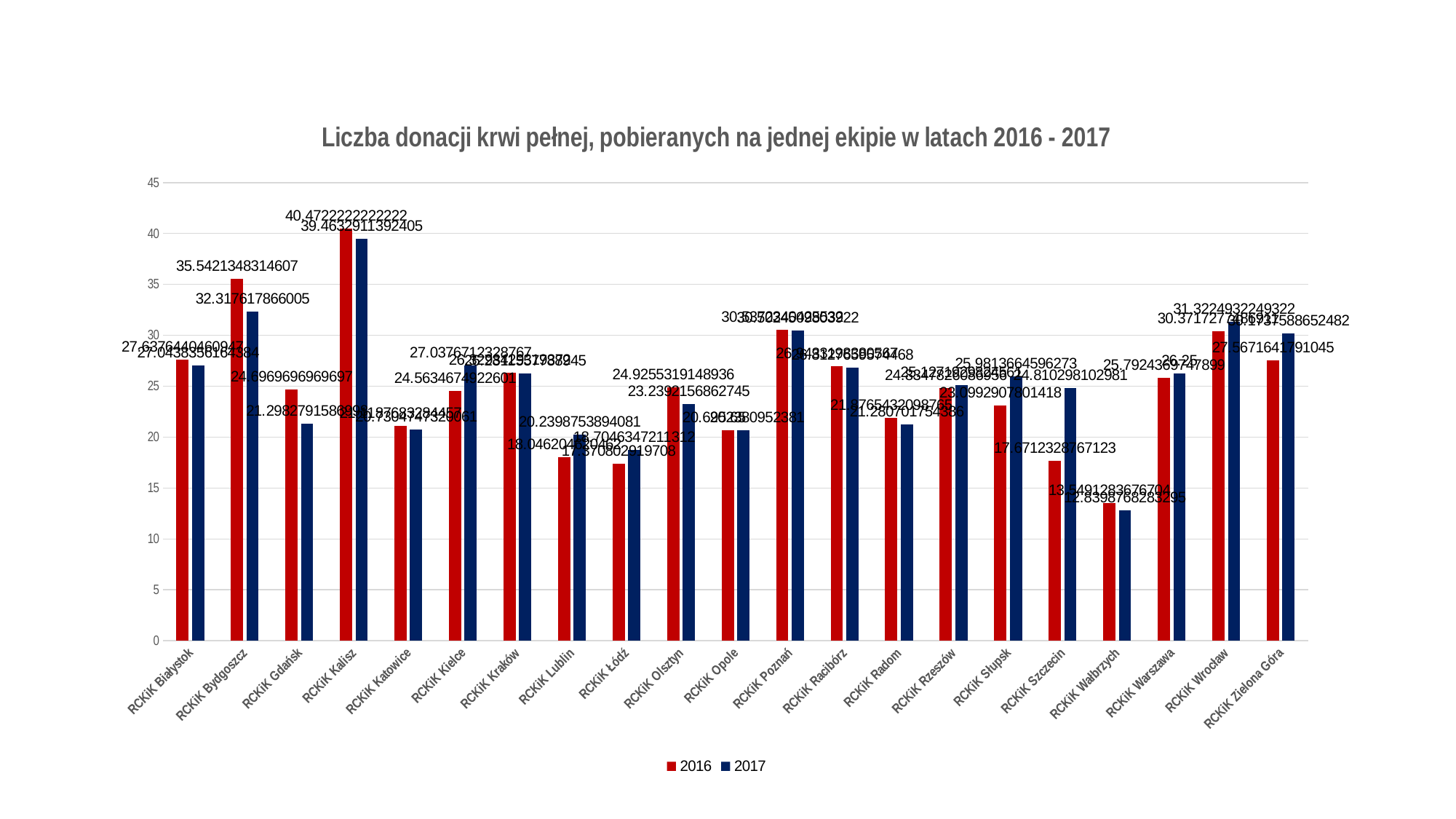
What is the 2016 value for RCKiK Kalisz? 40.4722222222222 How many RCKiK centres are shown on the x axis? 21 Which centre has the lowest value for 2016? RCKiK Wałbrzych What is the 2017 value for RCKiK Warszawa? 26.25 Is the 2017 value for RCKiK Wałbrzych greater or less than 15? less What kind of chart is shown on the slide? bar chart For RCKiK Szczecin, which year has the larger value, 2016 or 2017? 2017 What is the 2016 value for RCKiK Bydgoszcz? 35.5421348314607 What is the title of the chart? Liczba donacji krwi pełnej, pobieranych na jednej ekipie w latach 2016 - 2017 How many series does the legend list? 2 Which centre has the highest value for 2016? RCKiK Kalisz What is the 2016 value for RCKiK Szczecin? 17.6712328767123